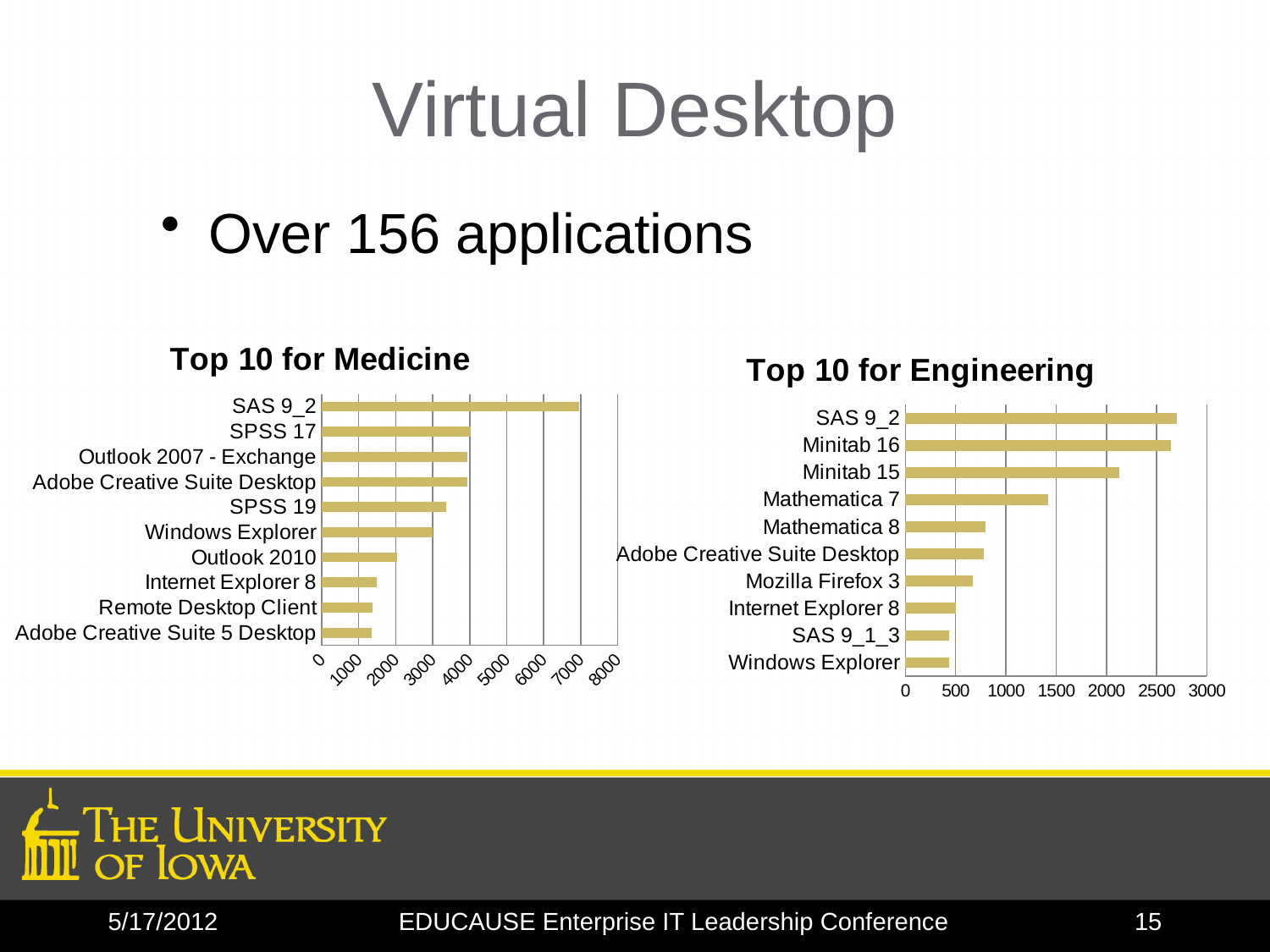
In the 'Top 10 for Engineering' chart, is the value for Minitab 15 greater or less than 2000? greater What kind of chart is the 'Top 10 for Medicine' chart? bar chart How many applications are shown in the 'Top 10 for Medicine' chart? 10 In the 'Top 10 for Medicine' chart, which is larger, the value for SPSS 17 or the value for Windows Explorer? SPSS 17 How many applications are shown in the 'Top 10 for Engineering' chart? 10 In the 'Top 10 for Medicine' chart, which application has the highest value? SAS 9_2 In the 'Top 10 for Engineering' chart, which is larger, the value for Minitab 15 or the value for Mathematica 7? Minitab 15 What is the title of the chart on the right side of the slide? Top 10 for Engineering In the 'Top 10 for Engineering' chart, is the value for Mathematica 8 greater or less than 1000? less In the 'Top 10 for Medicine' chart, is the value for Outlook 2010 greater or less than 3000? less